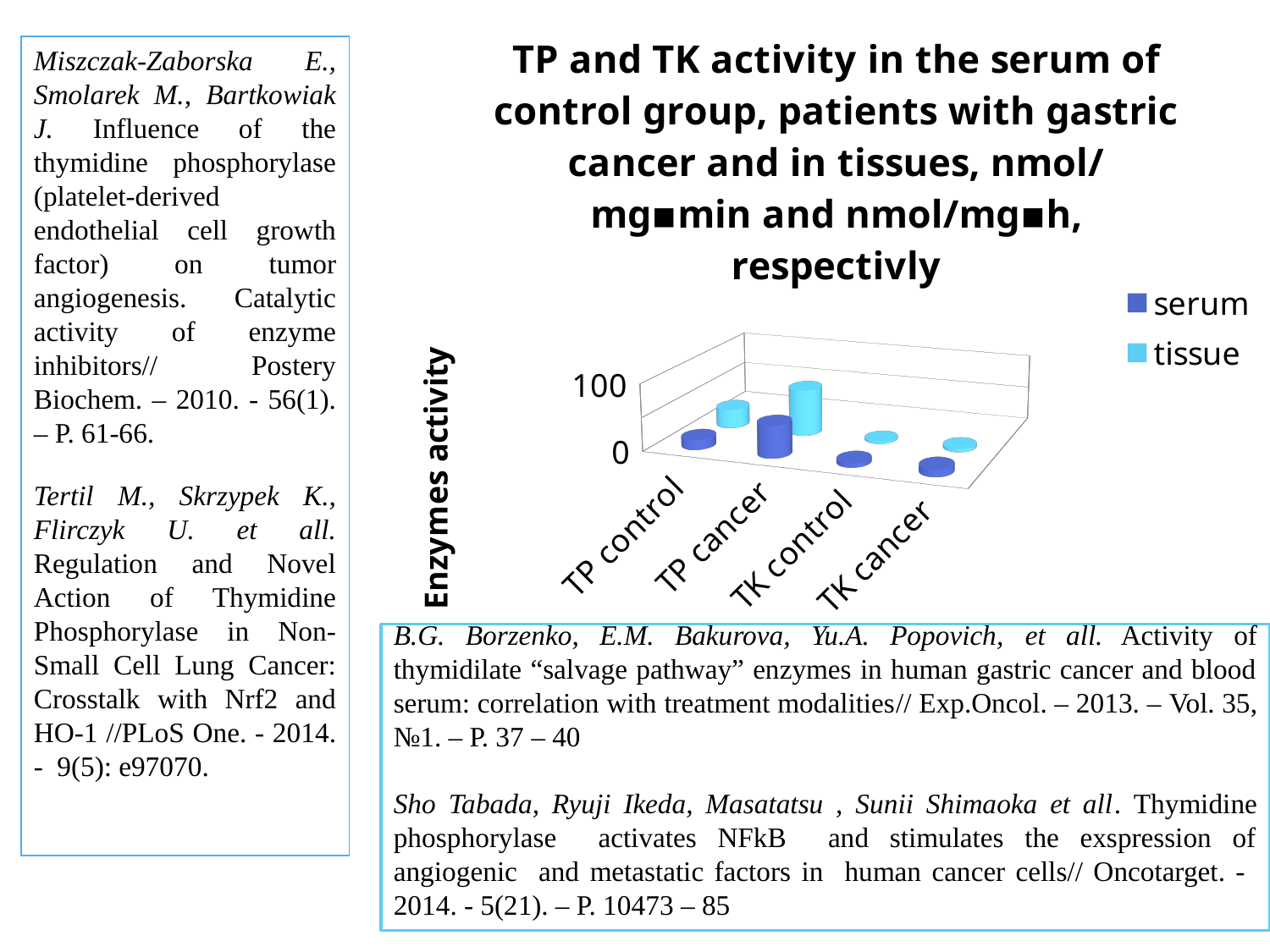
Is the serum value for TP cancer larger or smaller than the serum value for TP control? larger Which category has the highest tissue value? TP cancer How many categories are shown on the x axis of the chart? 4 How many series does the chart legend list? 2 Is the serum value for TP cancer greater or less than 100? less Is the tissue value for TP cancer larger or smaller than the tissue value for TP control? larger What kind of chart is shown on the slide? bar chart Which series are listed in the chart legend? serum, tissue Which category has the highest serum value? TP cancer What is the title of the vertical axis of the chart? Enzymes activity Is the tissue value for TP cancer larger or smaller than the serum value for TP cancer? larger Is the tissue value for TK control greater or less than 100? less